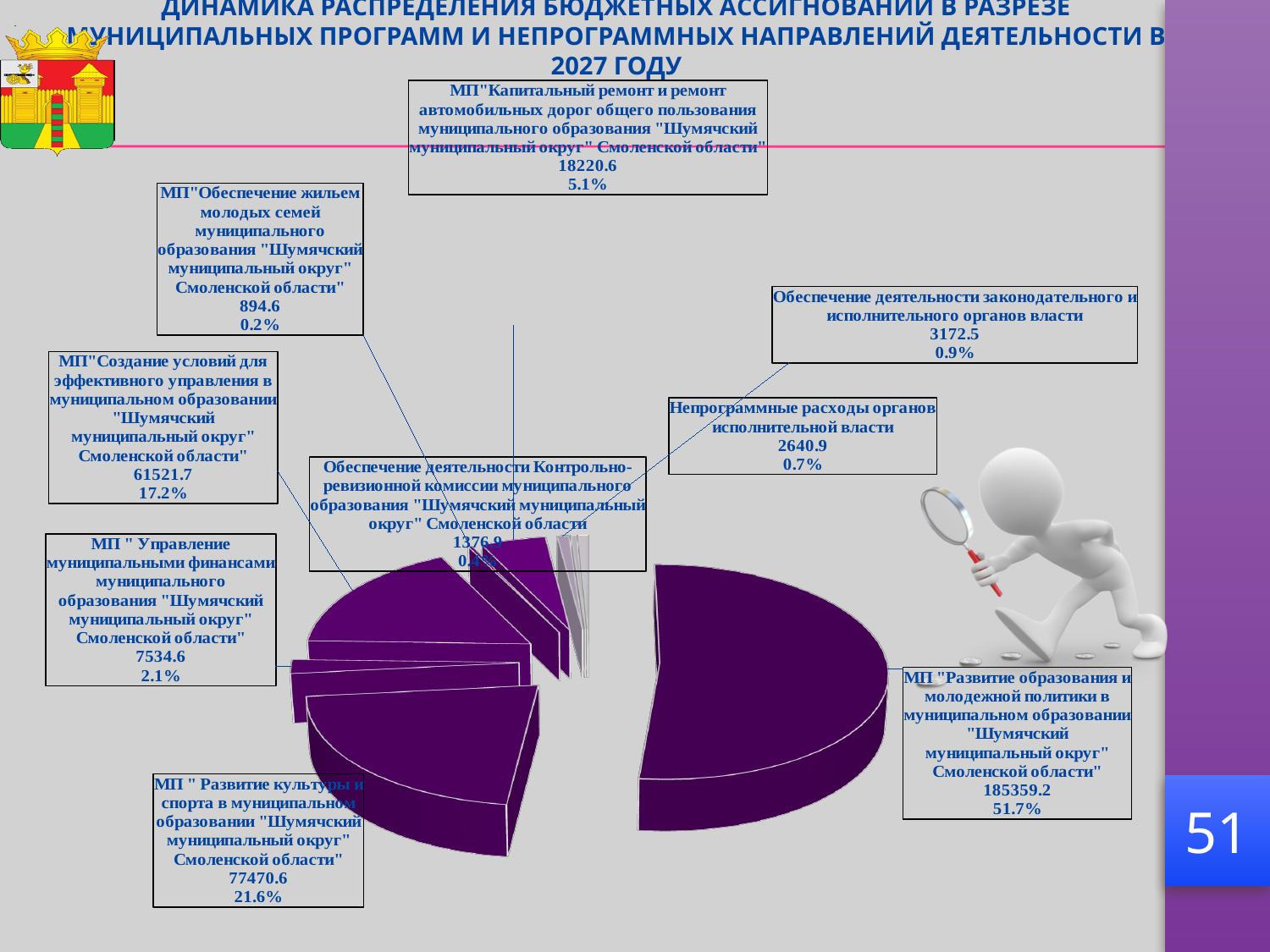
What is the value for МП "Капитальный ремонт и ремонт автомобильных дорог"? 18220.6 Which is larger: МП "Управление муниципальными финансами" or Обеспечение деятельности законодательного и исполнительного органов власти? МП "Управление муниципальными финансами" What is the difference between the values for МП "Развитие культуры и спорта" and МП "Создание условий для эффективного управления"? 15948.9 What share of the pie does МП "Создание условий для эффективного управления" take? 17.2% Which category has the smallest value? МП "Обеспечение жильем молодых семей" What share of the pie does МП "Развитие образования и молодежной политики" take? 51.7% What is the value for МП "Развитие образования и молодежной политики"? 185359.2 What kind of chart is shown on the slide? pie chart What is the value for МП "Развитие культуры и спорта"? 77470.6 What share of the pie does Непрограммные расходы органов исполнительной власти take? 0.7% Which category has the largest value? МП "Развитие образования и молодежной политики" How many categories are shown in the pie chart? 9